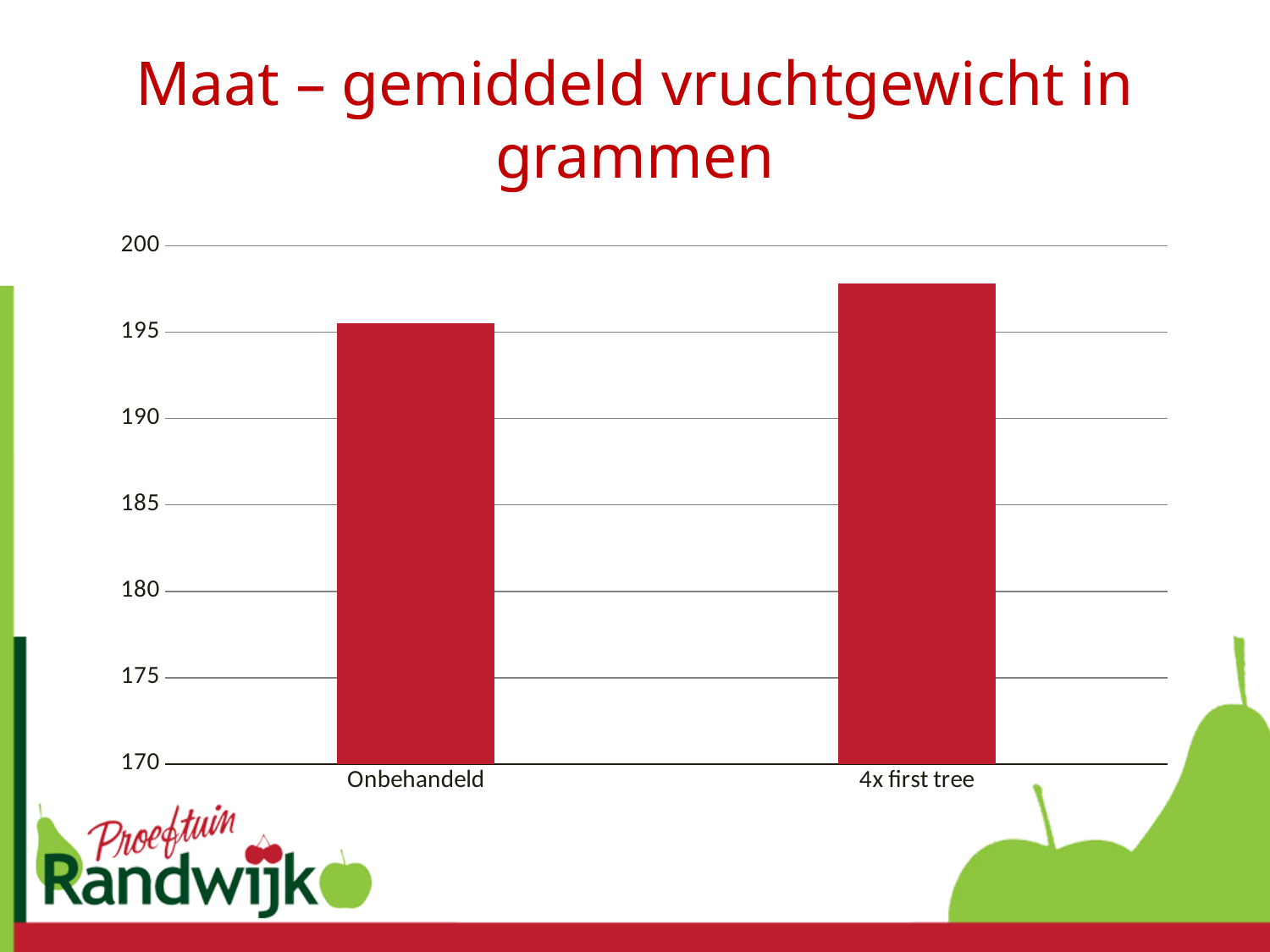
How many categories are plotted in the chart? 2 Which is larger, the value for Onbehandeld or the value for 4x first tree? 4x first tree Is the value for Onbehandeld greater or less than 190? greater Is the value for 4x first tree greater or less than 200? less Do the values rise or fall from left to right along the x axis? rise What is the title of the chart on the slide? Maat – gemiddeld vruchtgewicht in grammen What is the lowest value shown on the vertical axis? 170 Which category has the lowest average fruit weight? Onbehandeld What kind of chart is shown on the slide? bar chart Is the value for 4x first tree greater or less than 195? greater Which category has the highest average fruit weight? 4x first tree